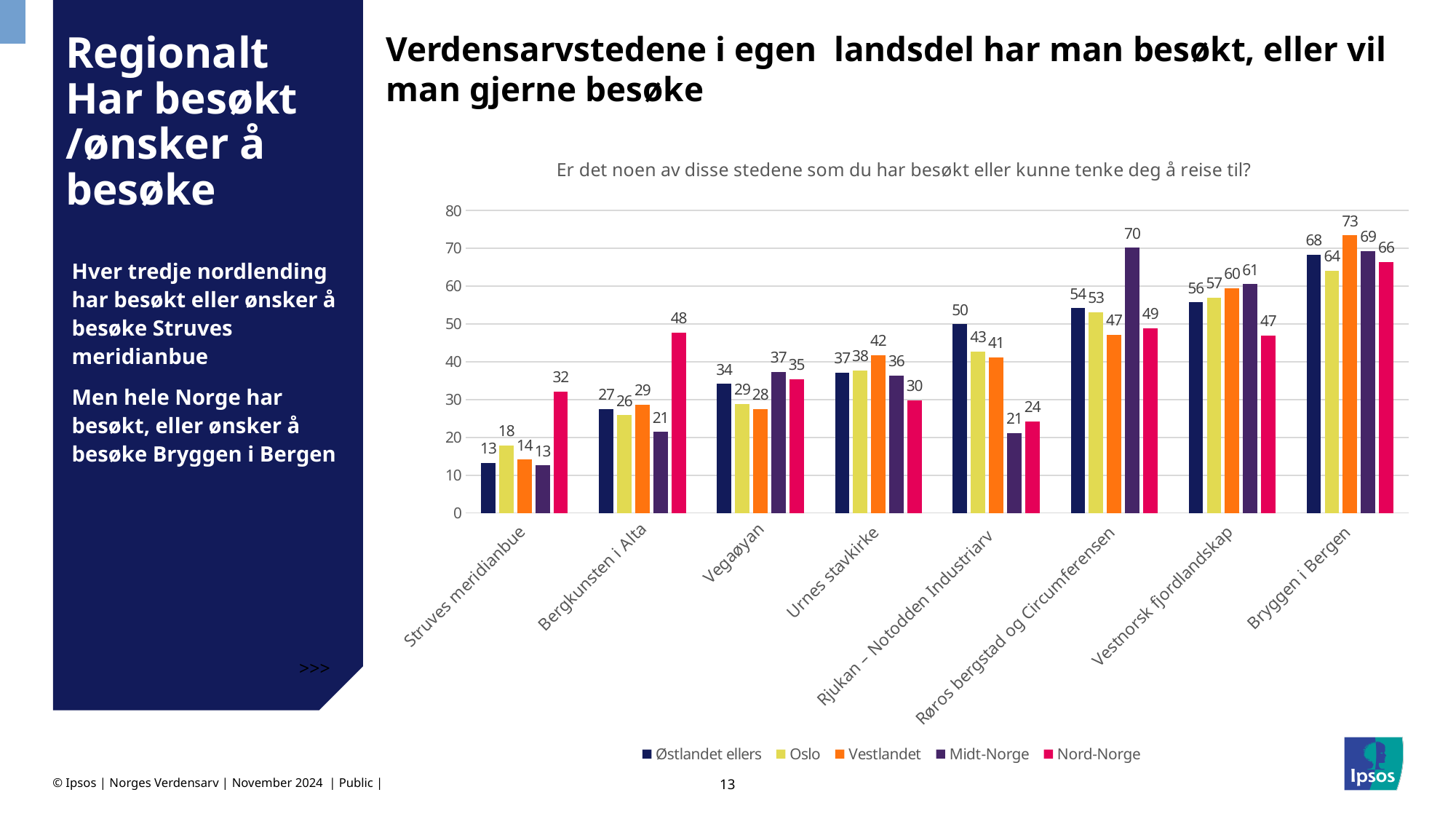
Which is larger for Vestnorsk fjordlandskap: the value for Oslo or the value for Nord-Norge? Oslo What is the value for Nord-Norge for Struves meridianbue? 32 What is the value for Østlandet ellers for Rjukan – Notodden Industriarv? 50 Which region has the highest value for Bergkunsten i Alta? Nord-Norge What is the value for Midt-Norge for Røros bergstad og Circumferensen? 70 What is the difference between the Nord-Norge and Midt-Norge values for Bergkunsten i Alta? 27 How many world heritage sites (categories) are shown on the x axis? 8 What kind of chart is shown on the slide? Bar chart How many series does the legend list? 5 What question is shown as the chart's subtitle above the plot? Er det noen av disse stedene som du har besøkt eller kunne tenke deg å reise til? What is the value for Vestlandet for Bryggen i Bergen? 73 Which region has the lowest value for Rjukan – Notodden Industriarv? Midt-Norge